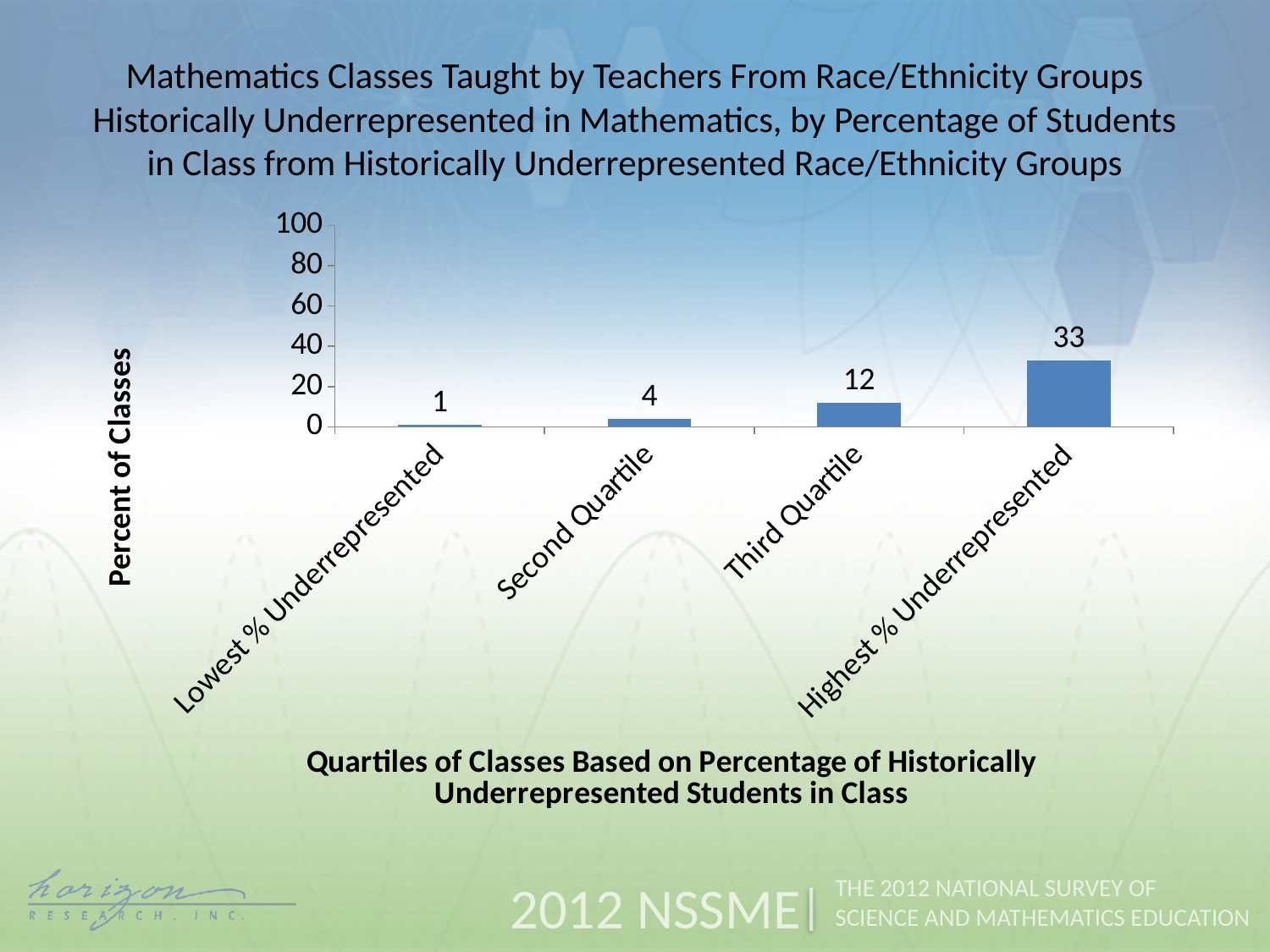
How many quartile categories are shown on the x axis? 4 What is the percent of classes for the Third Quartile? 12 Which has a larger percent of classes, the Second Quartile or the Third Quartile? Third Quartile What is the percent of classes for the Lowest % Underrepresented quartile? 1 Which quartile has the lowest percent of classes? Lowest % Underrepresented What is the difference in percent of classes between the Highest % Underrepresented quartile and the Third Quartile? 21 Which quartile has the highest percent of classes? Highest % Underrepresented What is the percent of classes for the Second Quartile? 4 What kind of chart is shown on the slide? Bar chart Do the values rise or fall moving from the Lowest % Underrepresented quartile to the Highest % Underrepresented quartile? Rise Is the value for the Highest % Underrepresented quartile greater or less than 20? greater What is the percent of classes for the Highest % Underrepresented quartile? 33